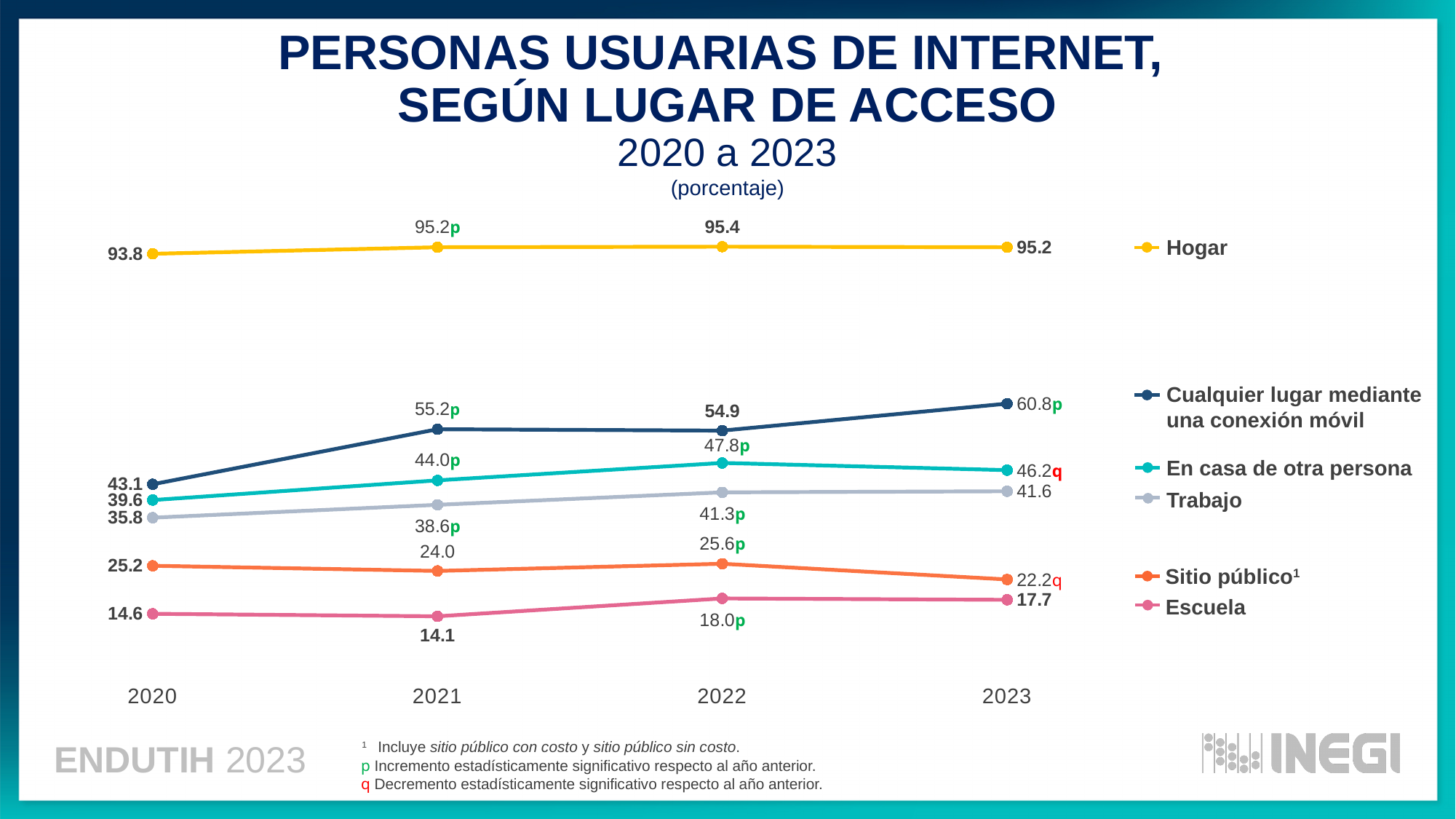
How many series does the legend list? 6 Does the value for Sitio público rise or fall from 2022 to 2023? Fall Which series has the highest value in 2023? Hogar What is the value for Escuela in 2021? 14.1 What is the difference between the Hogar value in 2022 and the Hogar value in 2020? 1.6 What kind of chart is shown on the slide? Line chart What is the value for Cualquier lugar mediante una conexión móvil in 2023? 60.8 What is the value for Hogar in 2020? 93.8 Which is larger in 2021: En casa de otra persona or Trabajo? En casa de otra persona What is the value for Trabajo in 2022? 41.3 How many years are shown on the x axis? 4 Which series has the lowest value in 2020? Escuela